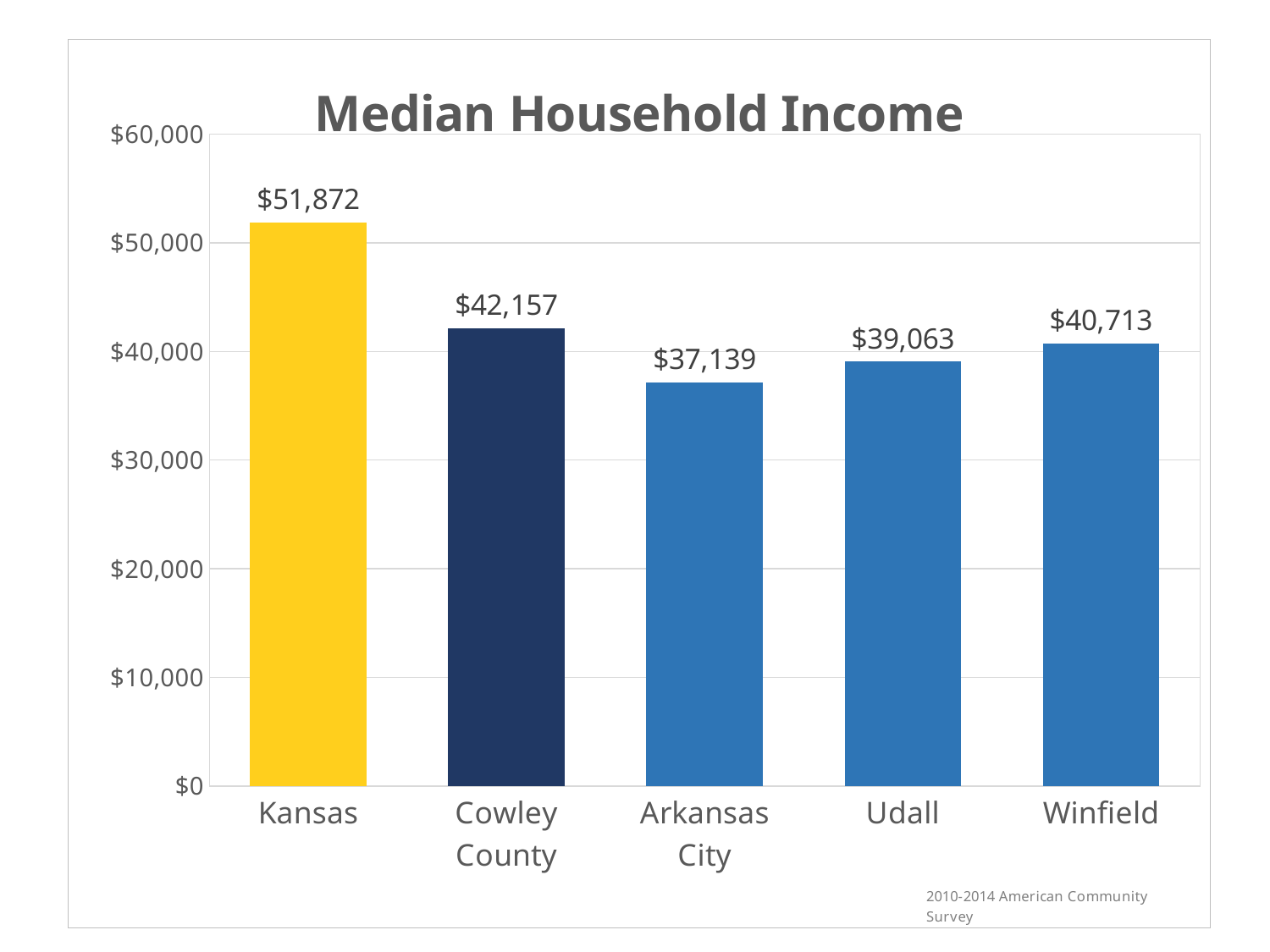
Which has a higher median household income, Udall or Winfield? Winfield Which category has the lowest median household income? Arkansas City What is the difference between the median household income of Kansas and Cowley County? $9,715 What is the median household income for Cowley County? $42,157 What is the median household income for Arkansas City? $37,139 Which category has the highest median household income? Kansas What is the median household income for Kansas? $51,872 What is the median household income for Udall? $39,063 What kind of chart is shown on the slide? Bar chart How many categories are shown in the chart? 5 What is the median household income for Winfield? $40,713 What is the title of the chart? Median Household Income